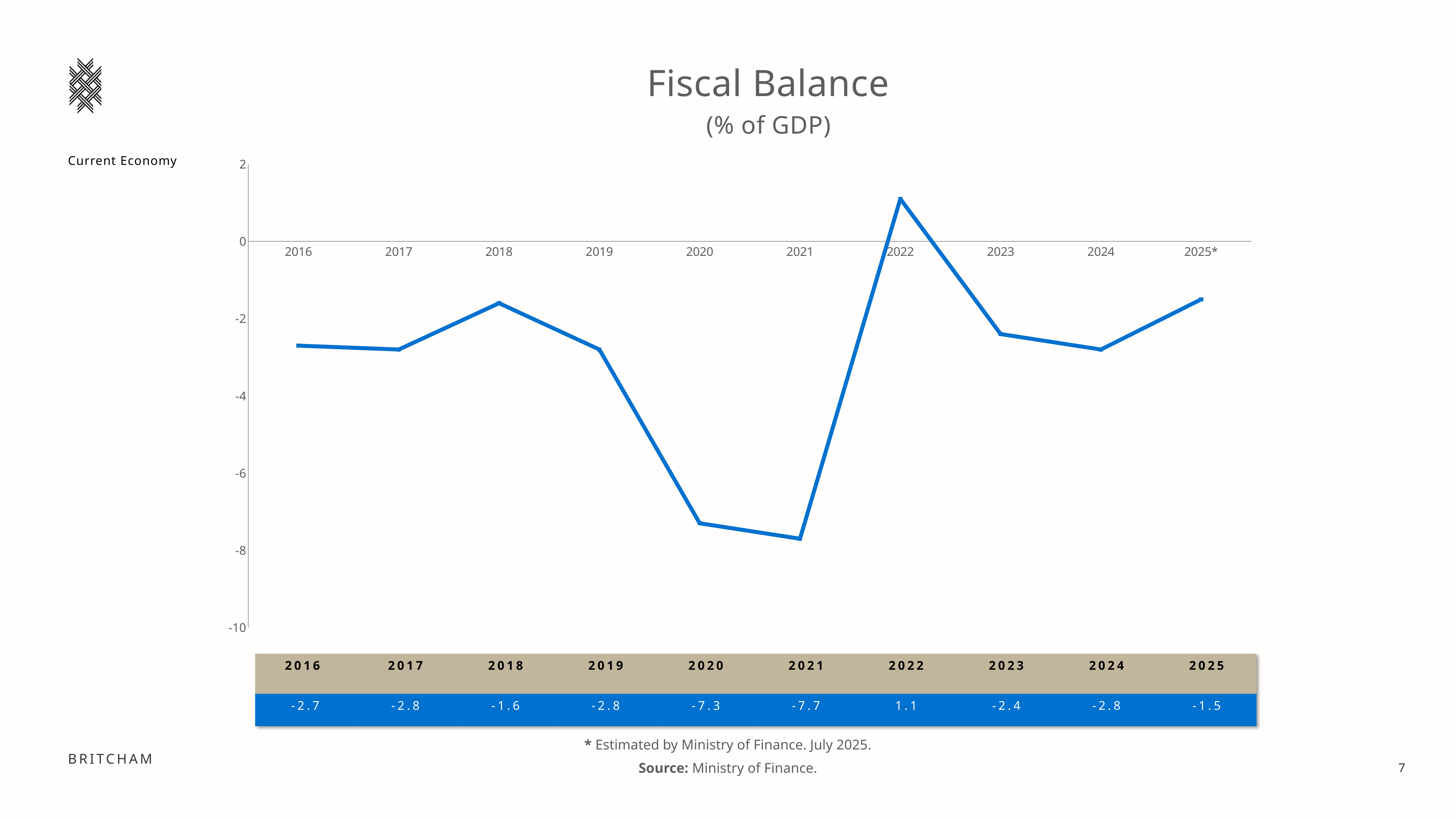
What is the difference between the fiscal balance in 2022 and in 2021? 8.8 Which year has the lowest fiscal balance? 2021 What is the title of the chart? Fiscal Balance (% of GDP) Is the fiscal balance for 2021 greater or less than -6? less What kind of chart is shown on the slide? line chart Which year has a higher fiscal balance, 2018 or 2019? 2018 Does the fiscal balance rise or fall from 2019 to 2021? fall What is the estimated fiscal balance (% of GDP) for 2025? -1.5 How many years are plotted on the chart? 10 What is the fiscal balance (% of GDP) for 2022? 1.1 Which year has the highest fiscal balance? 2022 What is the fiscal balance (% of GDP) for 2020? -7.3